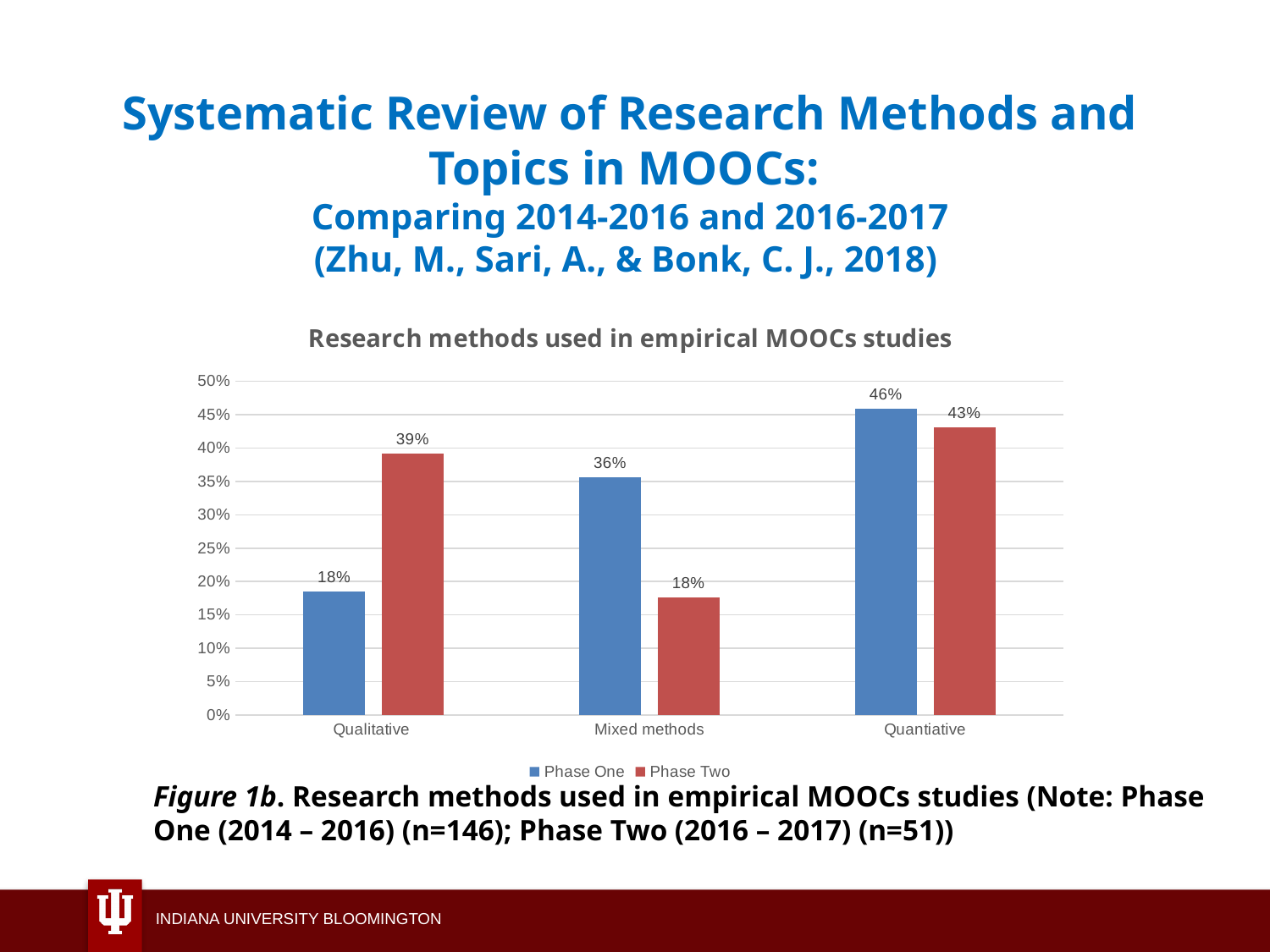
What is the Phase One value for Qualitative? 18% What is the difference between the Phase Two and Phase One values for Qualitative? 21% What is the Phase Two value for Quantiative? 43% How many categories are shown on the x axis? 3 Which category has the lowest Phase Two value? Mixed methods What is the Phase Two value for Mixed methods? 18% Which category has the highest Phase One value? Quantiative What kind of chart is shown? Bar chart What is the difference between the Phase One and Phase Two values for Mixed methods? 18% How many series does the legend list? 2 What is the title of the chart? Research methods used in empirical MOOCs studies Which is larger for Quantiative, Phase One or Phase Two? Phase One